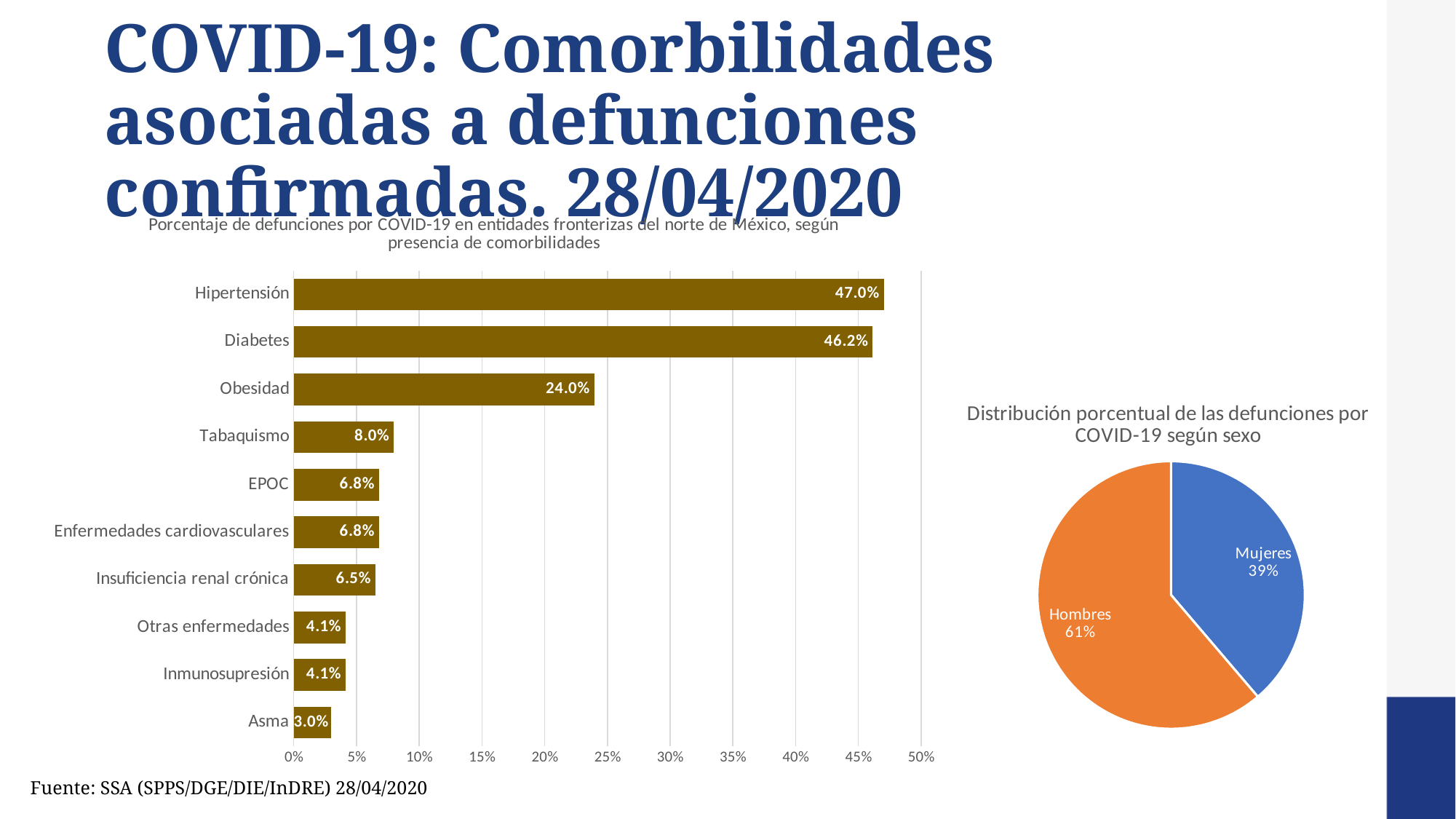
In the pie chart on the right, what is the value for Mujeres? 39% In the bar chart on the left, how many comorbidity categories are shown? 10 In the pie chart on the right, what share of deaths corresponds to Hombres? 61% In the bar chart on the left, which is larger, Tabaquismo or Insuficiencia renal crónica? Tabaquismo In the bar chart on the left, which comorbidity has the highest percentage? Hipertensión What kind of chart is the chart on the left? Bar chart In the pie chart on the right, which group has the larger share, Hombres or Mujeres? Hombres In the bar chart on the left, what is the value for Hipertensión? 47.0% In the bar chart on the left, which comorbidity has the lowest percentage? Asma What is the title of the pie chart on the right? Distribución porcentual de las defunciones por COVID-19 según sexo In the bar chart on the left, what is the value for Obesidad? 24.0% In the bar chart on the left, what is the difference between Hipertensión and Diabetes? 0.8%